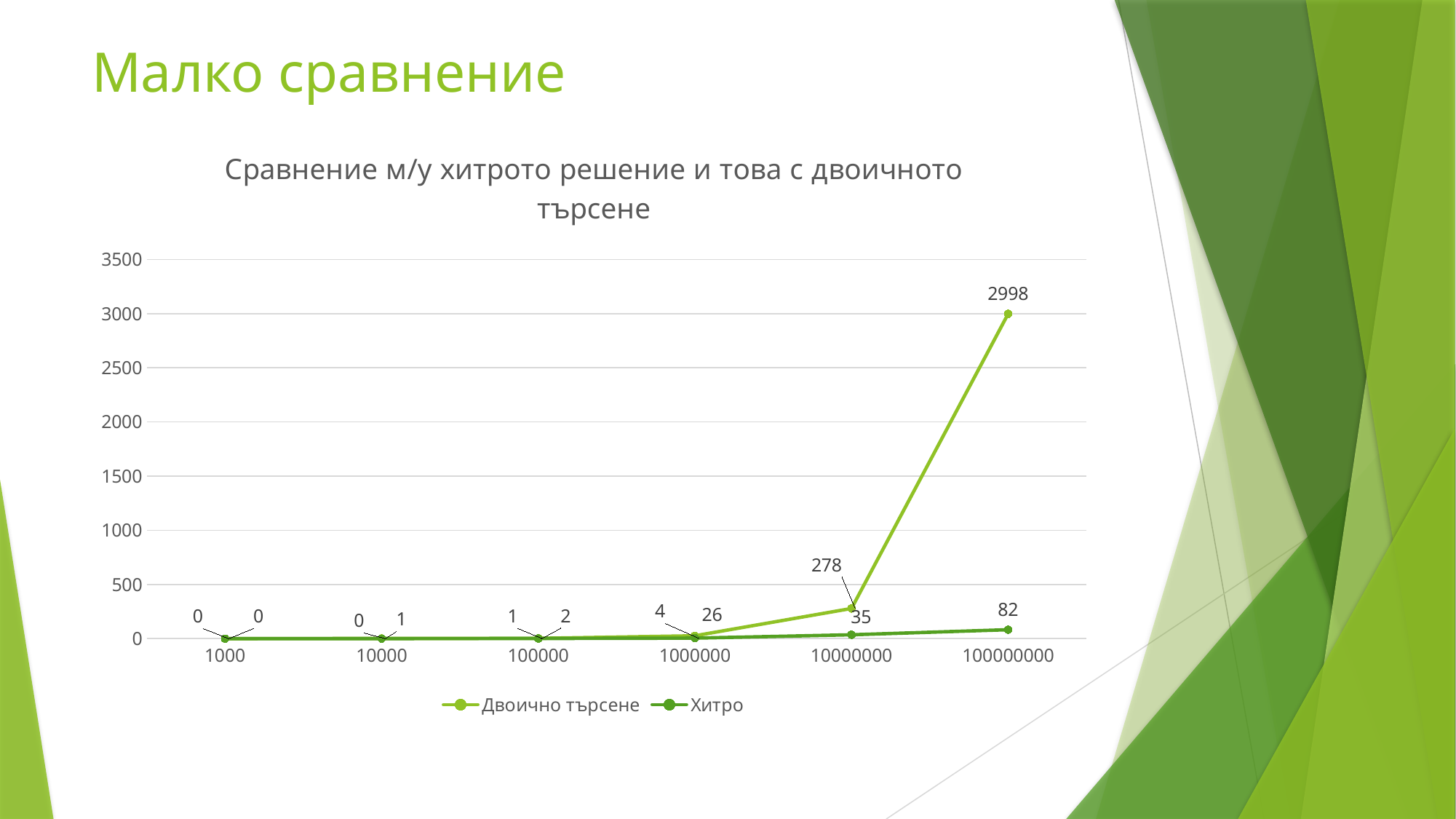
What is the value of Двоично търсене at 10000000? 278 What is the difference between Двоично търсене and Хитро at 100000000? 2916 How many series does the legend list? 2 What is the difference between Двоично търсене and Хитро at 10000000? 243 What kind of chart is shown on the slide? line chart What is the value of Двоично търсене at 100000000? 2998 At 100000000, which series has the larger value, Двоично търсене or Хитро? Двоично търсене What is the value of Хитро at 100000000? 82 What is the title of the chart? Сравнение м/у хитрото решение и това с двоичното търсене How many points are plotted along the x axis for each series? 6 What is the value of Хитро at 10000000? 35 At which x-axis value does Двоично търсене reach its highest value? 100000000